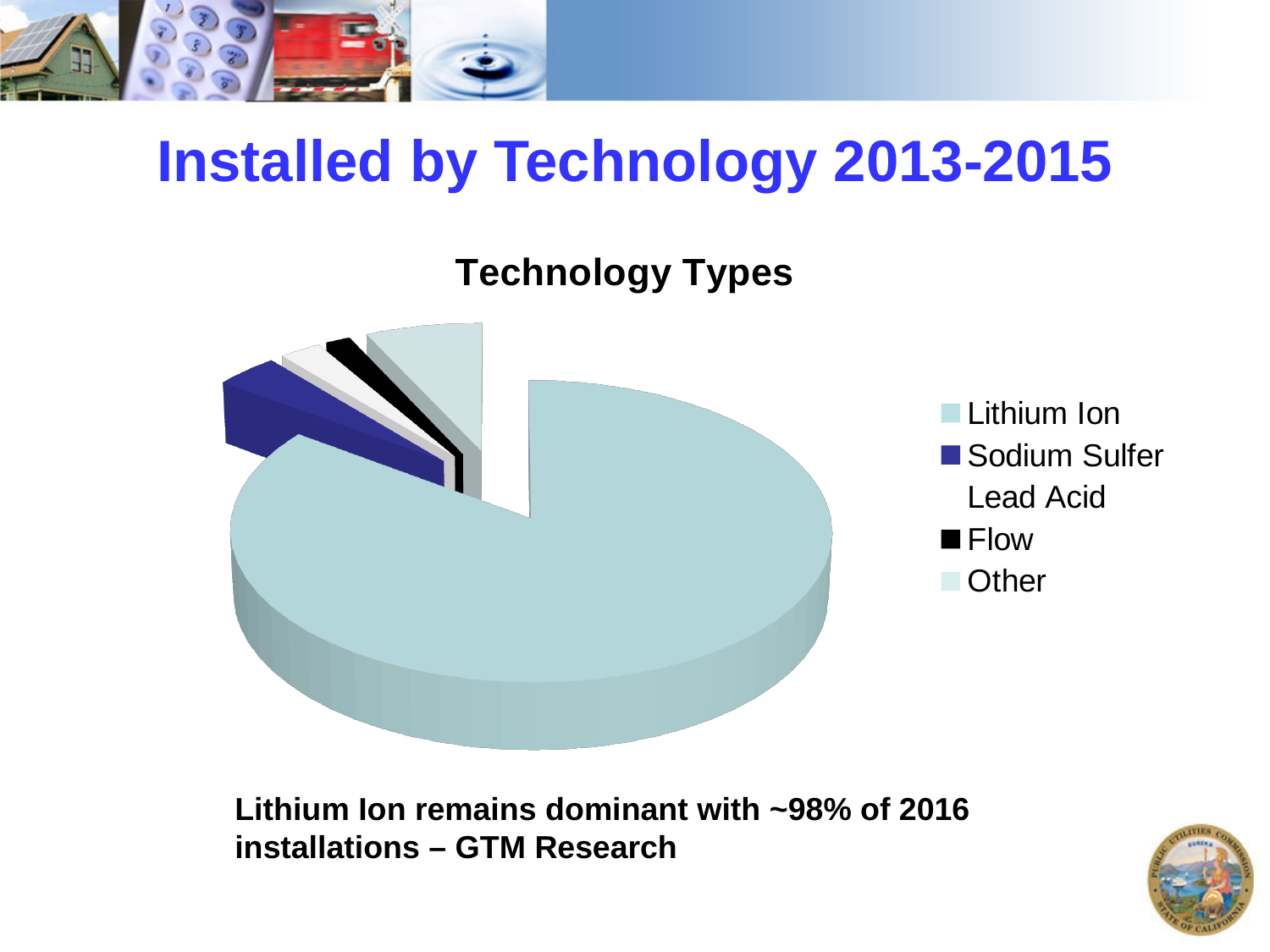
Which technology type has the largest slice of the pie? Lithium Ion How many technology categories does the pie chart show? 5 How many entries does the chart legend list? 5 Which is larger, the slice for Lithium Ion or the slice for Sodium Sulfer? Lithium Ion What is the title of the chart? Technology Types What kind of chart is shown on the slide? Pie chart What colour is the Flow slice in the pie chart? Black Which is larger, the slice for Sodium Sulfer or the slice for Flow? Sodium Sulfer Which is larger, the slice for Other or the slice for Flow? Other